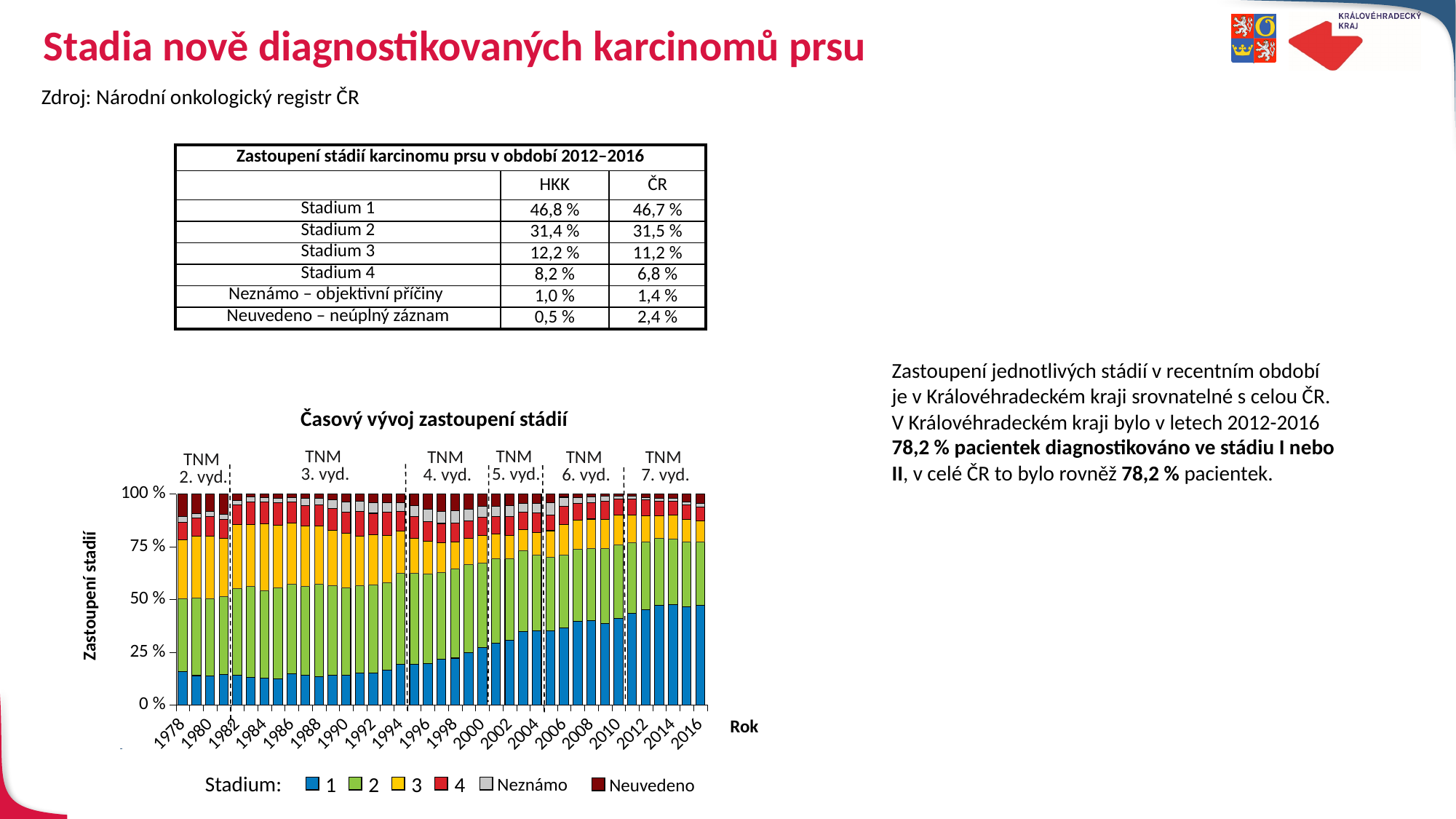
In the chart 'Časový vývoj zastoupení stádií', does the share of Stadium 1 rise or fall from 1978 to 2016? rise In the chart 'Časový vývoj zastoupení stádií', is the share of Stadium 1 in 2016 greater or less than 50 %? less In the chart 'Časový vývoj zastoupení stádií', is the share of Stadium 1 larger in 1978 or in 2016? 2016 What kind of chart is 'Časový vývoj zastoupení stádií'? stacked bar chart How many series does the legend of the chart 'Časový vývoj zastoupení stádií' list? 6 In the chart 'Časový vývoj zastoupení stádií', is the share of Stadium 1 in 1978 greater or less than 25 %? less In the chart 'Časový vývoj zastoupení stádií', is the share of Stadium 1 in 2006 greater or less than 25 %? greater What is the x-axis title of the chart 'Časový vývoj zastoupení stádií'? Rok How many year labels are shown on the x axis of the chart 'Časový vývoj zastoupení stádií'? 20 Which colour represents Stadium 1 in the legend of the chart 'Časový vývoj zastoupení stádií'? blue